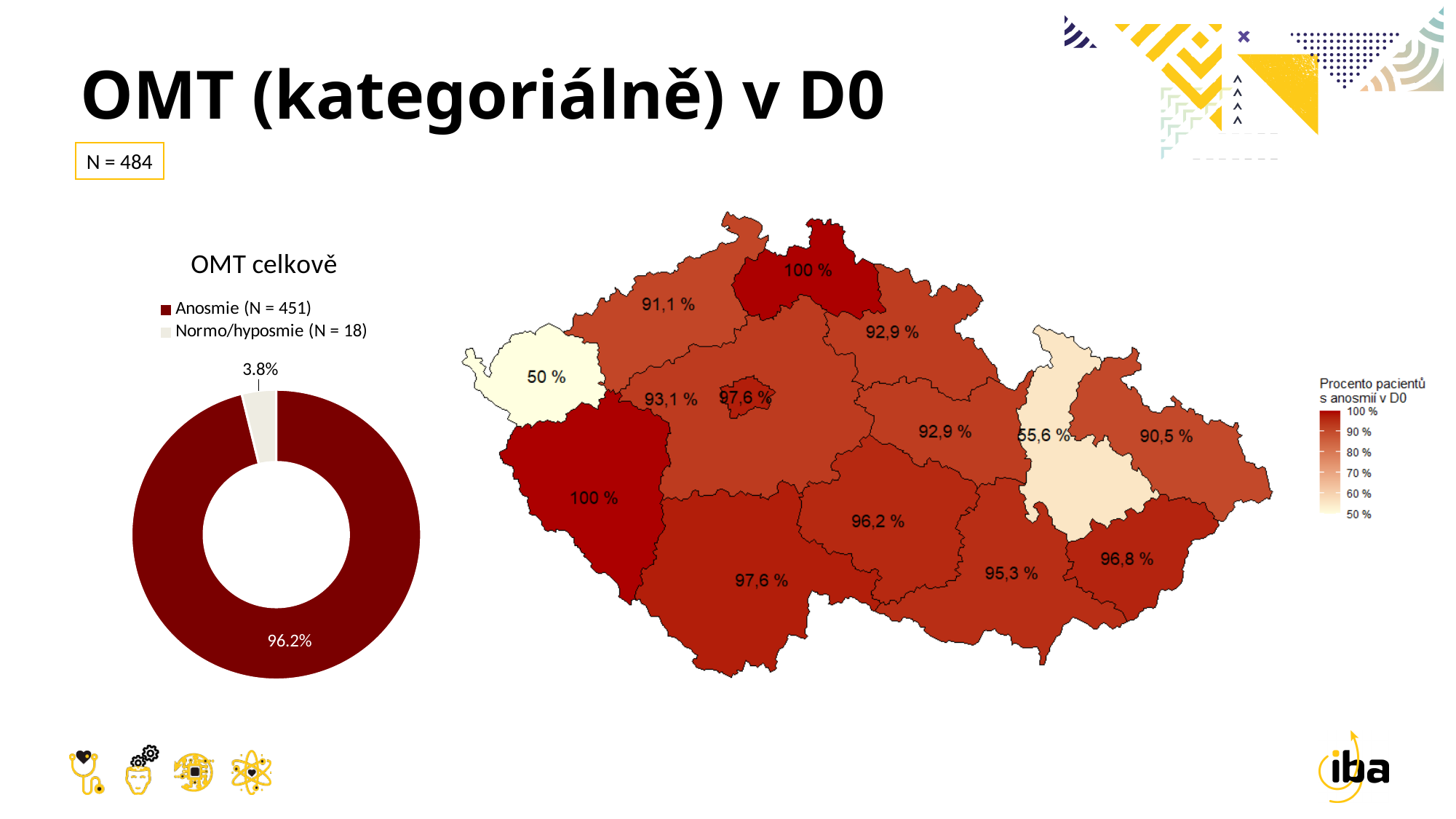
In the "OMT celkově" chart, what is the N given for Anosmie in the legend? 451 On the map chart, what is the highest percentage value labelled on any region? 100 % In the "OMT celkově" chart, what percentage is shown for Anosmie? 96.2% What is the title of the colour legend of the map chart? Procento pacientů s anosmií v D0 In the "OMT celkově" chart, what is the difference in percentage points between the Anosmie and Normo/hyposmie shares? 92.4 percentage points On the map chart, what is the lowest percentage value labelled on any region? 50 % How many categories does the legend of the "OMT celkově" chart list? 2 Which category has the largest share in the "OMT celkově" chart? Anosmie Which category has the smallest share in the "OMT celkově" chart? Normo/hyposmie In the "OMT celkově" chart, what percentage is shown for Normo/hyposmie? 3.8% What kind of chart is the "OMT celkově" chart on the left of the slide? Pie (donut) chart In the "OMT celkově" chart, what is the N given for Normo/hyposmie in the legend? 18